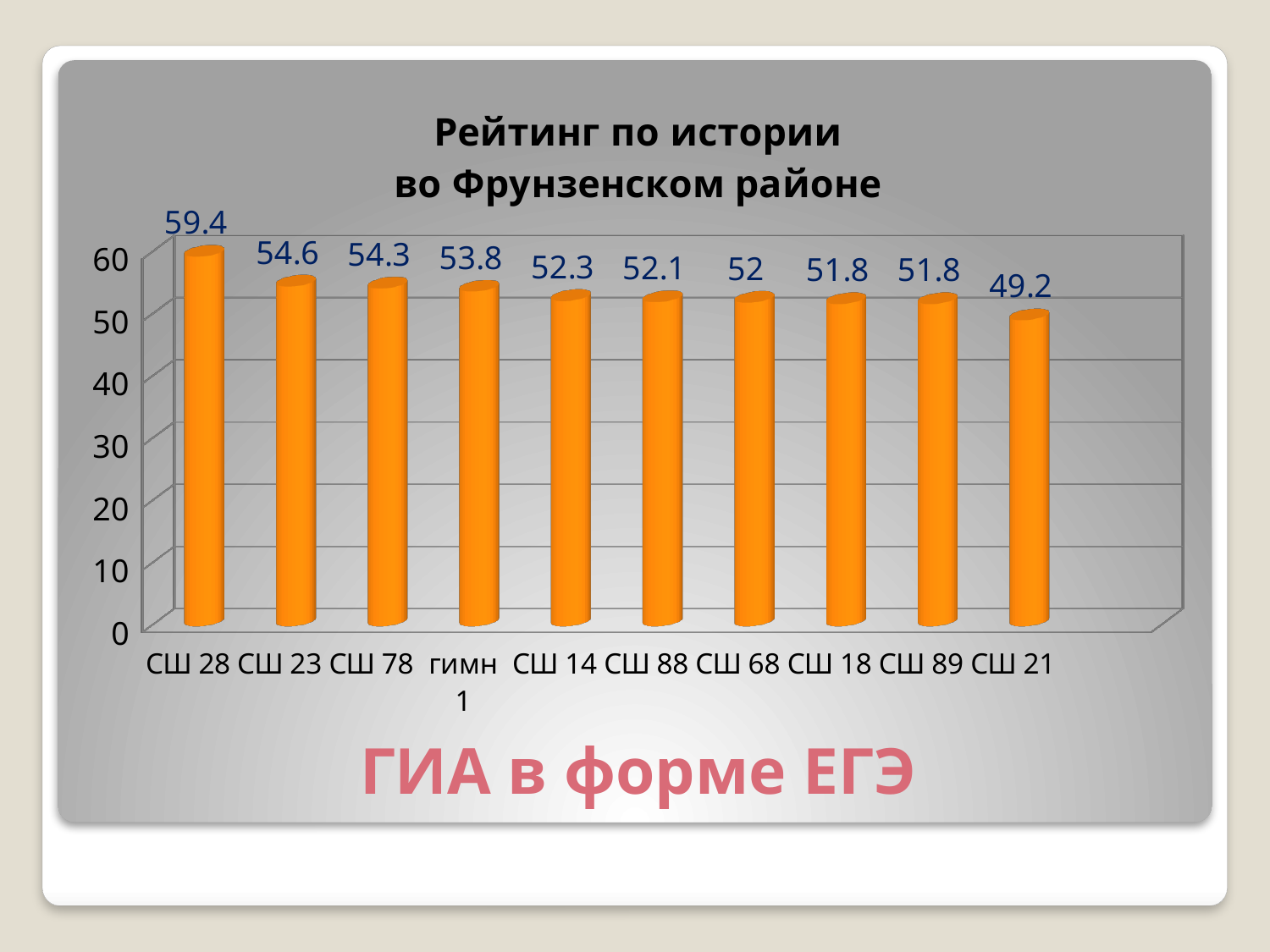
What kind of chart is shown on the slide? bar chart What is the value for СШ 21? 49.2 What is the value for гимн 1? 53.8 Do the values rise or fall from left to right along the x axis? fall What is the title of the chart? Рейтинг по истории во Фрунзенском районе What is the value for СШ 68? 52 What is the value for СШ 28? 59.4 Which category has the highest value? СШ 28 Which category has the lowest value? СШ 21 Which is larger, the value for СШ 23 or the value for СШ 14? СШ 23 What is the difference between the values for СШ 28 and СШ 21? 10.2 How many categories are shown on the chart? 10